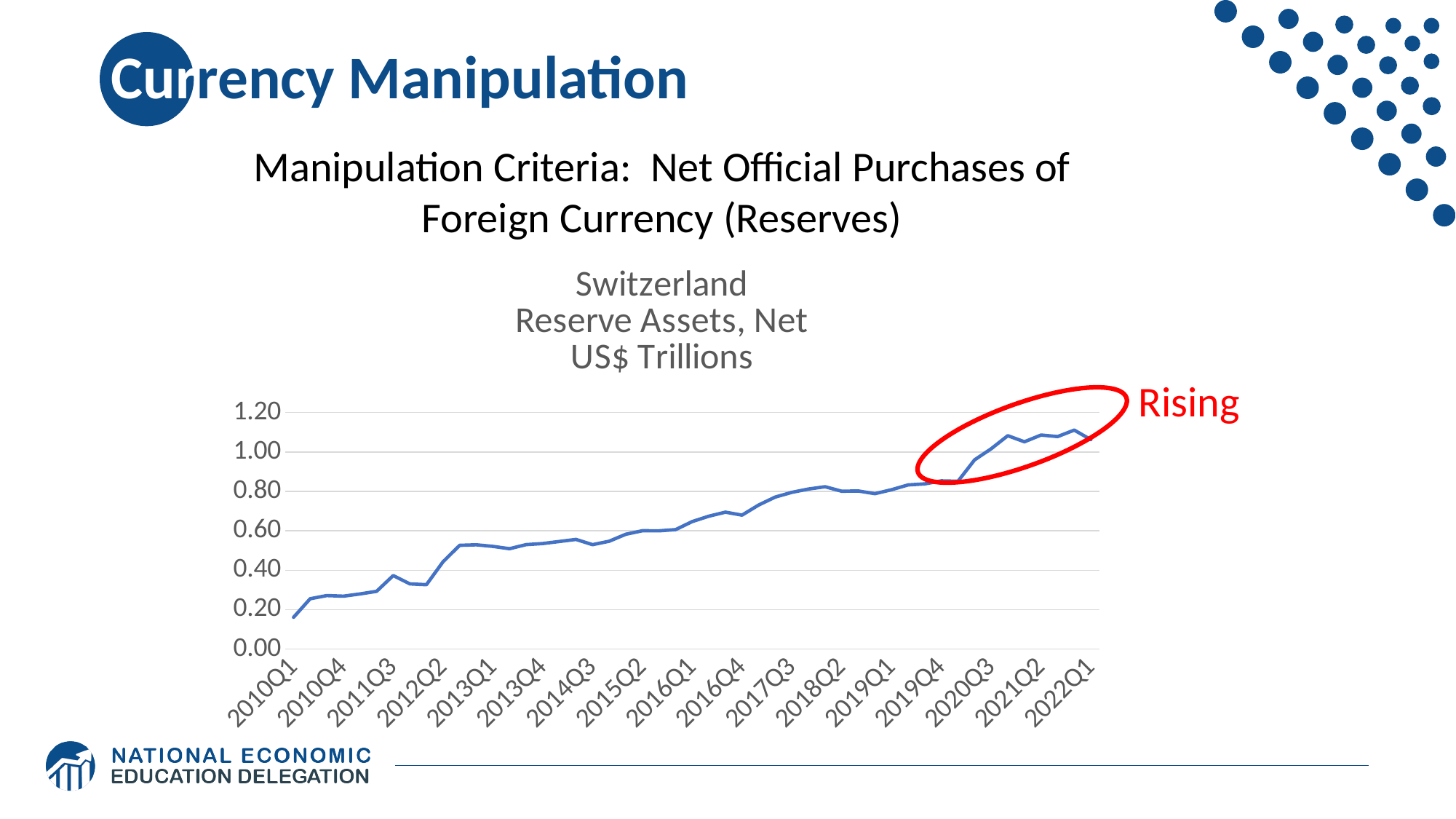
How many lines (series) are plotted on the chart? 1 Is the value for 2017Q3 greater or less than 0.60? greater What is the overall trend of Switzerland's net reserve assets from 2010Q1 to 2022Q1? Rising In what units are the reserve assets measured according to the chart title? US$ Trillions Which is larger, the value for 2010Q1 or the value for 2022Q1? 2022Q1 Is the value for 2014Q3 greater or less than 0.80? less What type of chart is shown on the slide? Line chart Is the value for 2021Q2 greater or less than 1.00? greater What word is written in red next to the circled portion of the line? Rising